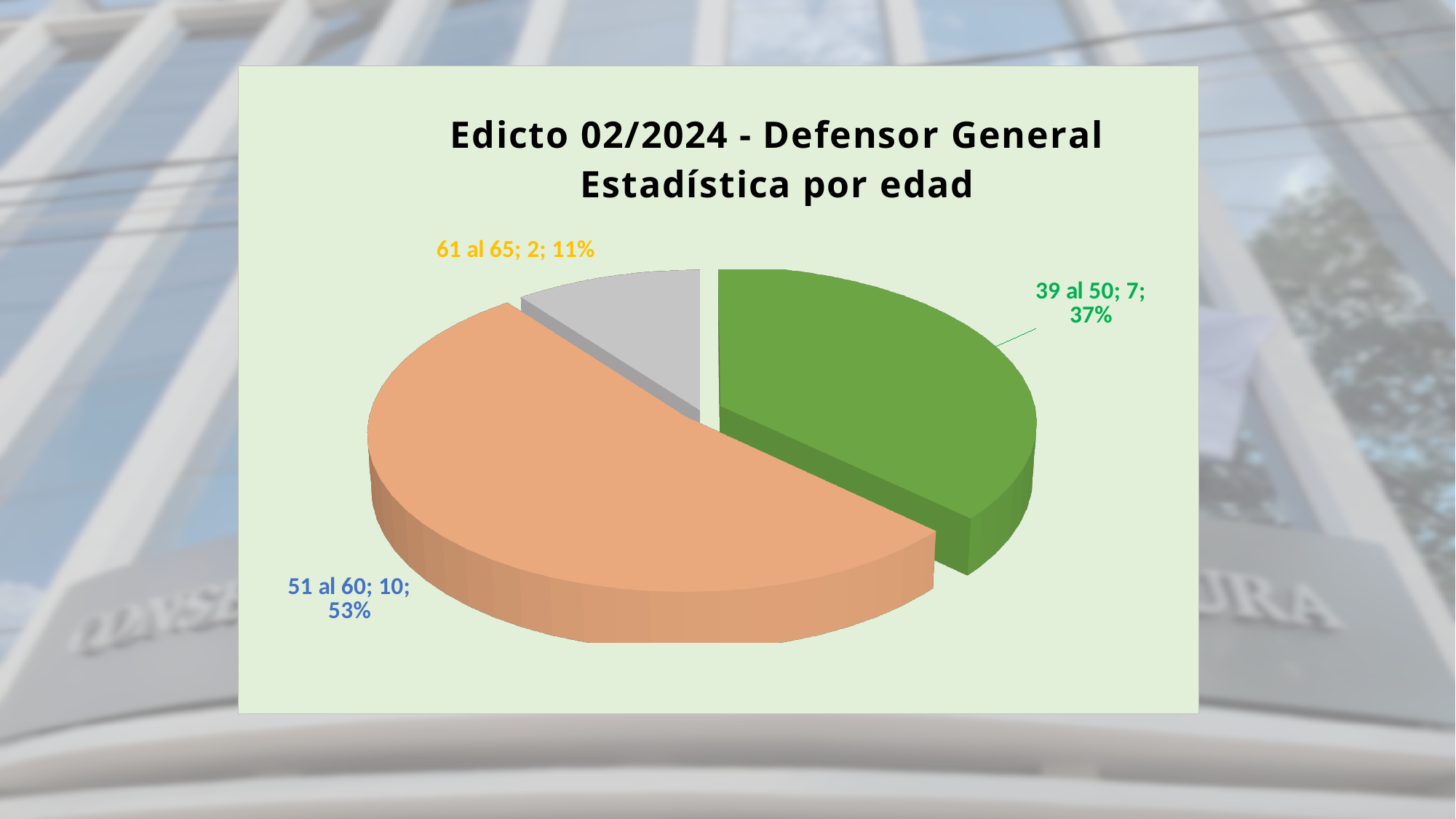
What share of the pie does the '39 al 50' slice represent? 37% What is the title of the chart? Edicto 02/2024 - Defensor General Estadística por edad What share of the pie does the '51 al 60' slice represent? 53% What is the value for the '61 al 65' category? 2 Which category has the largest slice? 51 al 60 Which category has the smallest slice? 61 al 65 What is the value for the '39 al 50' category? 7 What is the difference between the values for '51 al 60' and '39 al 50'? 3 How many slices does the pie chart have? 3 Which is larger, the value for '39 al 50' or the value for '61 al 65'? 39 al 50 What kind of chart is shown on the slide? pie chart What is the value for the '51 al 60' category? 10